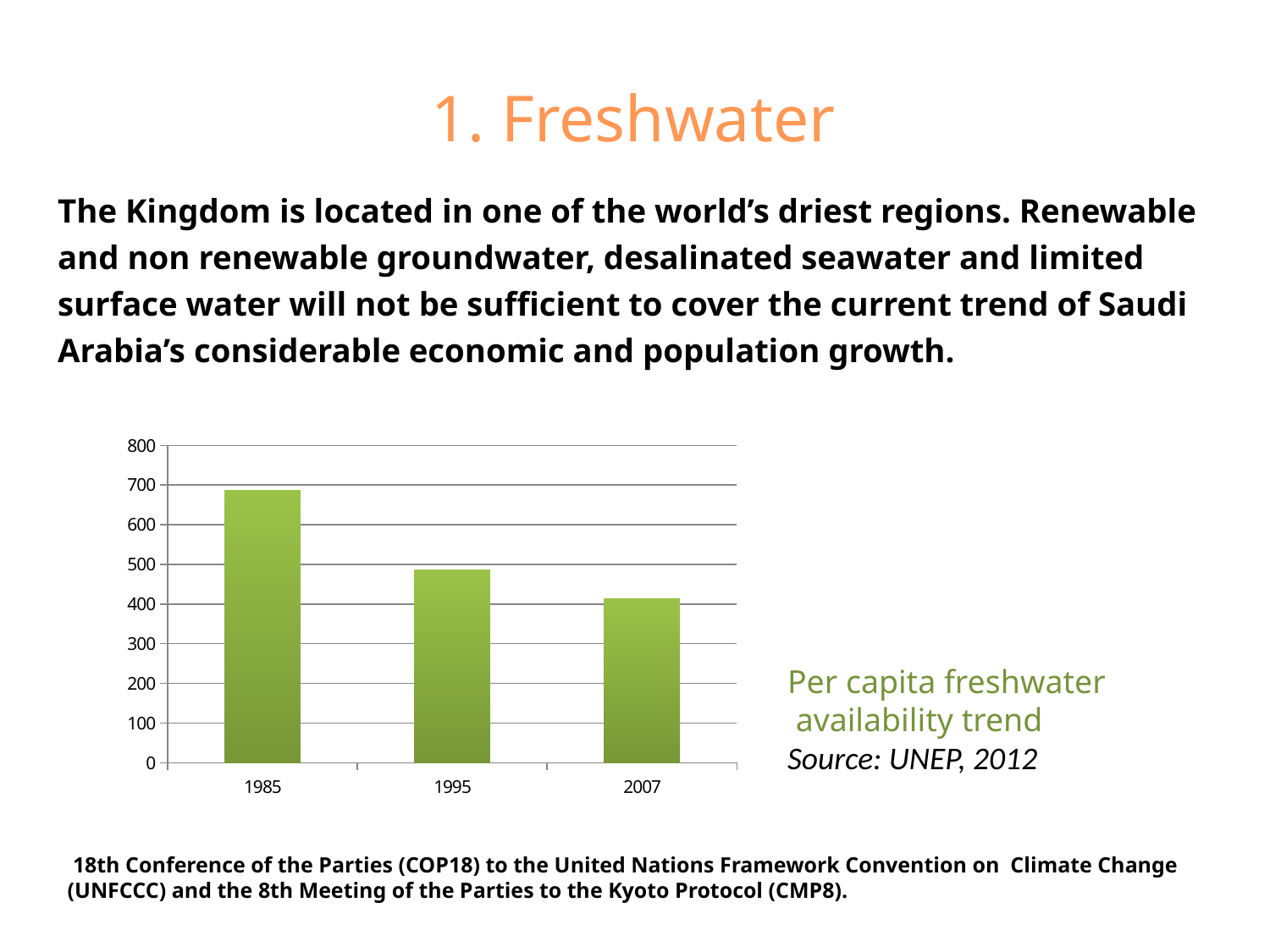
What source is cited for the chart? UNEP, 2012 Is the value for 1995 greater or less than 500? less What is the caption/title given for the chart? Per capita freshwater availability trend Which year has the lowest per capita freshwater availability? 2007 Is the value for 2007 greater or less than 400? greater Is the value for 1985 greater or less than 600? greater What kind of chart is shown on the slide? bar chart Which year has the highest per capita freshwater availability? 1985 Do the values rise or fall from 1985 to 2007? fall Which is larger, the value for 1995 or the value for 2007? 1995 How many bars (years) are plotted in the chart? 3